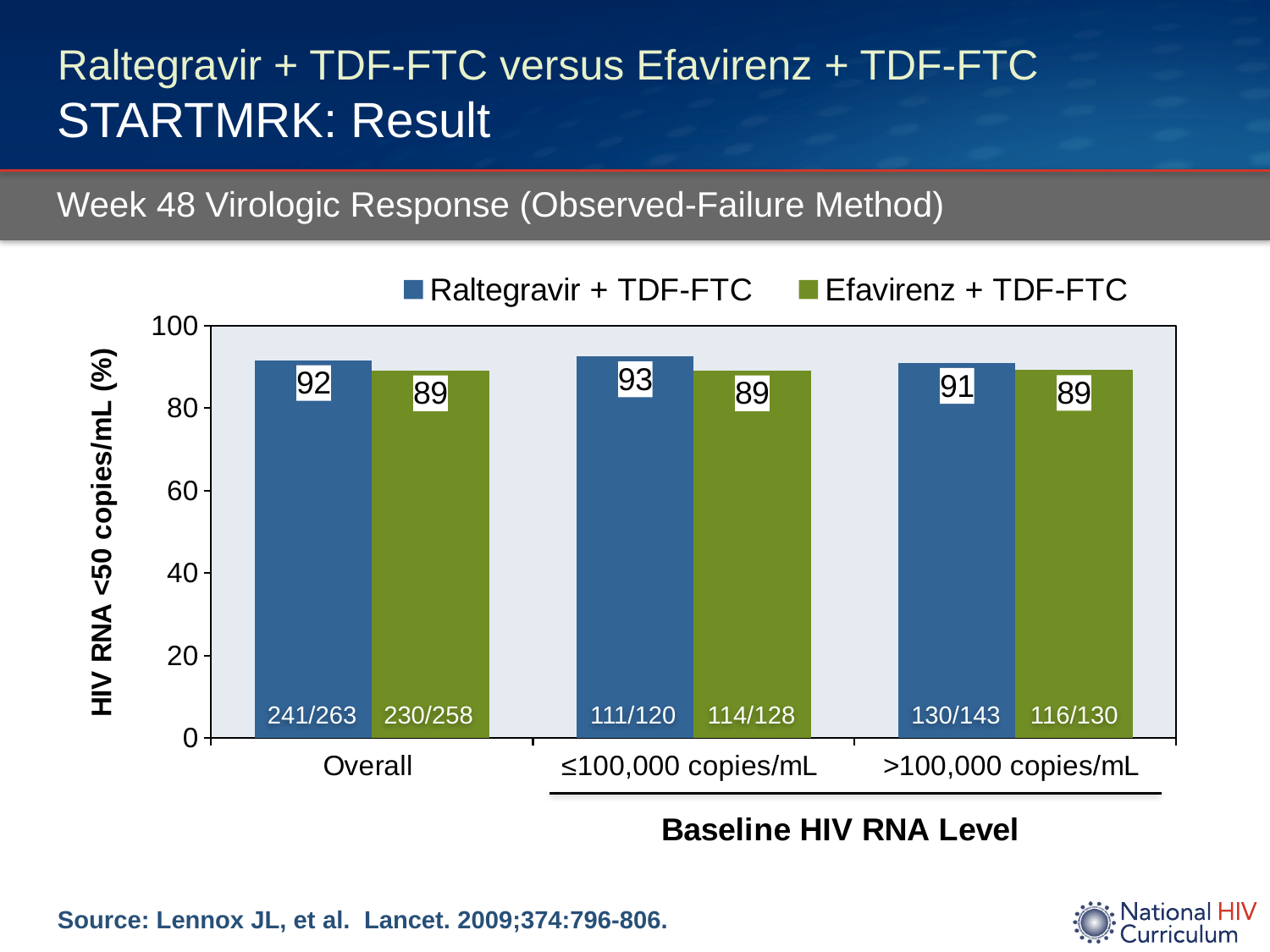
How many series does the legend list? 2 What kind of chart is shown on the slide? Bar chart Is the value for Efavirenz + TDF-FTC in the Overall category greater or less than 80? greater What fraction is printed on the Efavirenz + TDF-FTC bar in the Overall category? 230/258 In the Overall category, which series has the larger value, Raltegravir + TDF-FTC or Efavirenz + TDF-FTC? Raltegravir + TDF-FTC In which category does Raltegravir + TDF-FTC reach its highest value? ≤100,000 copies/mL What is the value for Raltegravir + TDF-FTC in the Overall category? 92 What is the difference between the Raltegravir + TDF-FTC and Efavirenz + TDF-FTC values in the ≤100,000 copies/mL category? 4 In which category does Raltegravir + TDF-FTC have its lowest value? >100,000 copies/mL What is the value for Raltegravir + TDF-FTC in the ≤100,000 copies/mL category? 93 How many categories are shown on the x axis? 3 What is the value for Efavirenz + TDF-FTC in the >100,000 copies/mL category? 89